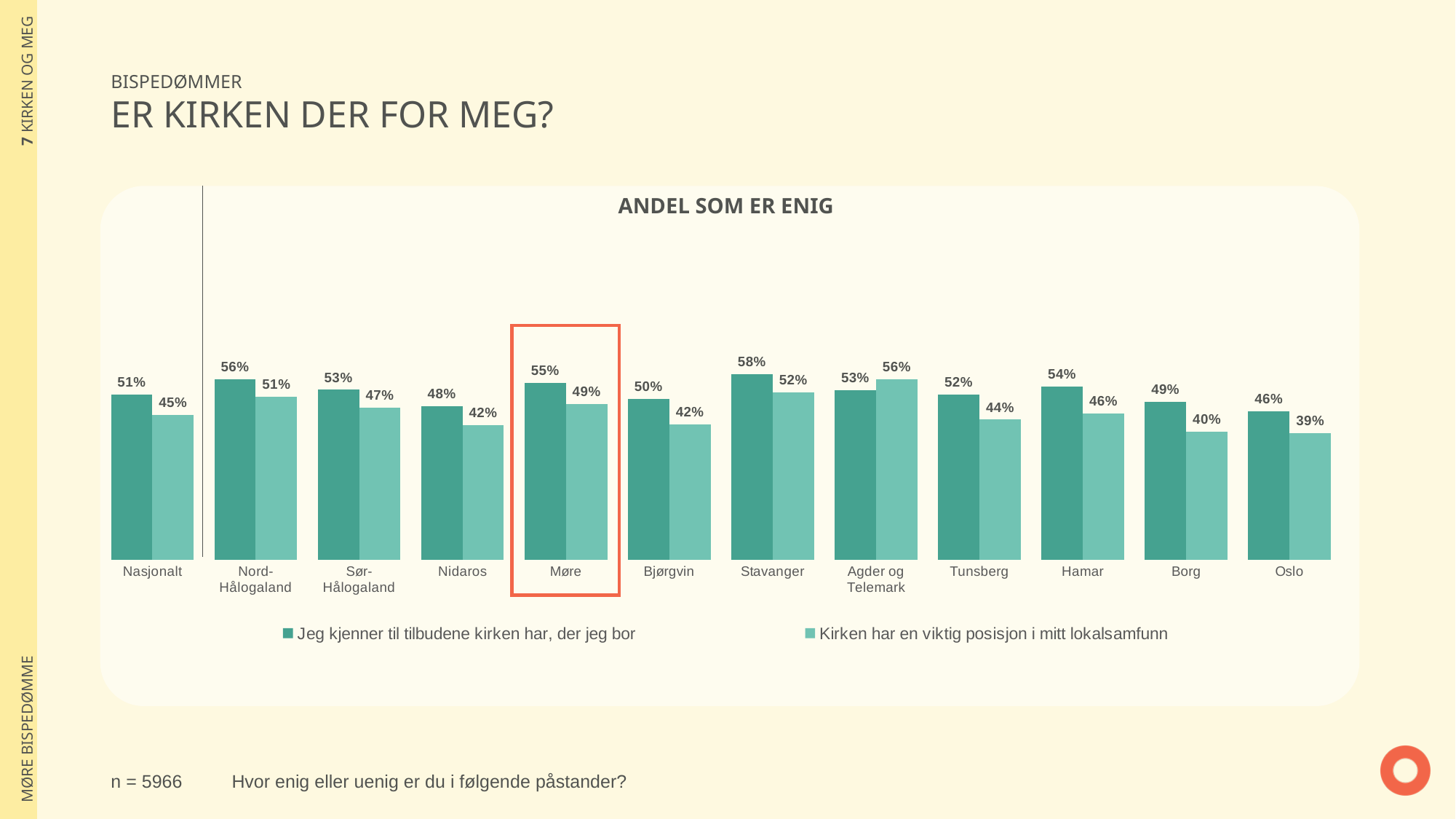
Which category has the highest value in the series "Jeg kjenner til tilbudene kirken har, der jeg bor"? Stavanger What is the title of the chart? ANDEL SOM ER ENIG What is the difference between the two series values for Nidaros? 6% How many categories are shown on the x axis? 12 Which is larger for Agder og Telemark: "Jeg kjenner til tilbudene kirken har, der jeg bor" or "Kirken har en viktig posisjon i mitt lokalsamfunn"? Kirken har en viktig posisjon i mitt lokalsamfunn Which category has the lowest value in the series "Kirken har en viktig posisjon i mitt lokalsamfunn"? Oslo What type of chart is shown on the slide? bar chart What is the value for Møre in the series "Jeg kjenner til tilbudene kirken har, der jeg bor"? 55% Which category has the highest value in the series "Kirken har en viktig posisjon i mitt lokalsamfunn"? Agder og Telemark What is the value for Nasjonalt in the series "Kirken har en viktig posisjon i mitt lokalsamfunn"? 45% What is the value for Oslo in the series "Kirken har en viktig posisjon i mitt lokalsamfunn"? 39% How many series does the legend list? 2